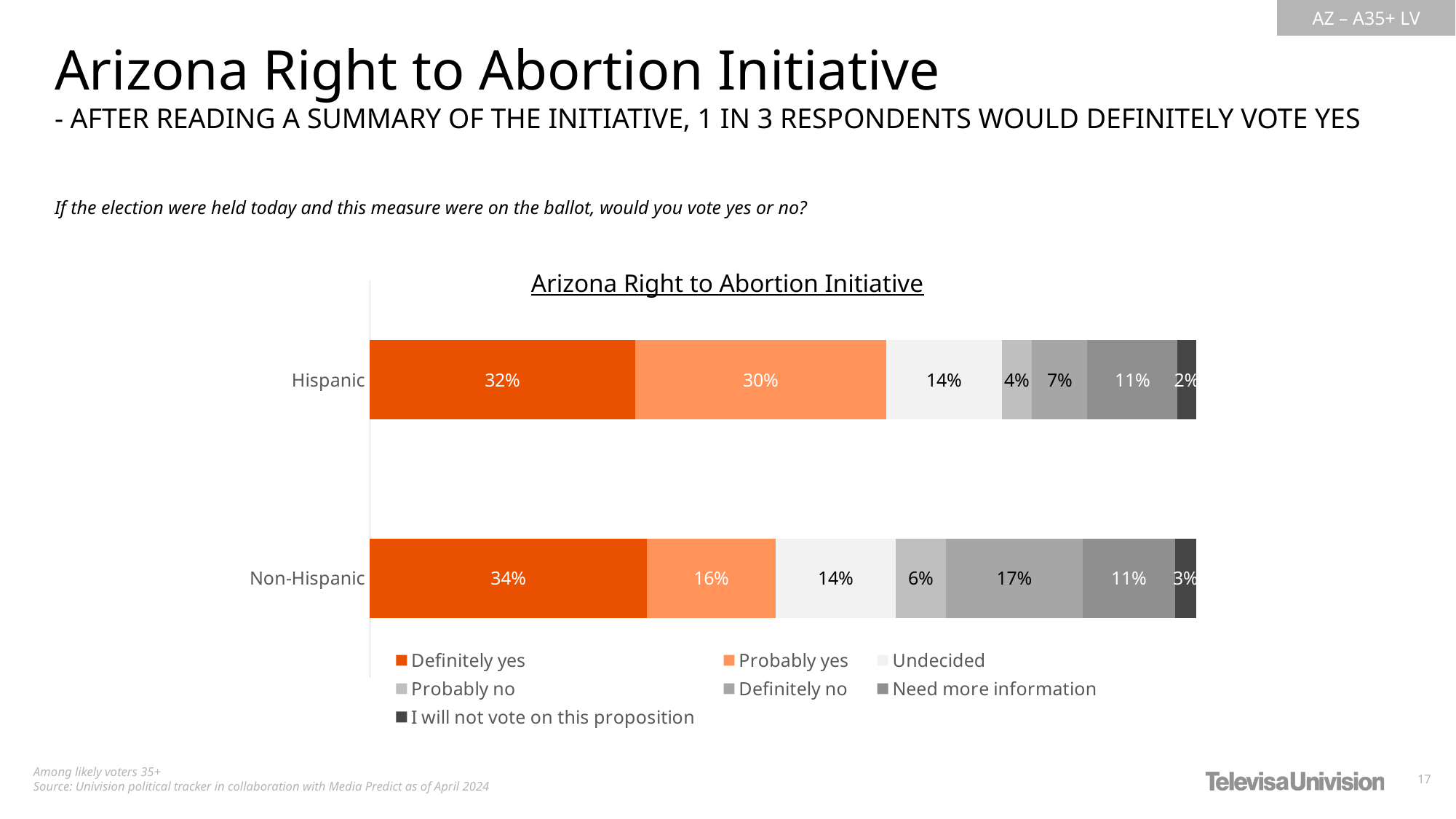
How many series does the legend list? 7 What percentage of Hispanic respondents would definitely vote yes? 32% What is the title of the chart? Arizona Right to Abortion Initiative Which response category has the highest value in the Hispanic bar? Definitely yes What share of Hispanic respondents said they need more information? 11% Which response category has the lowest value in the Non-Hispanic bar? I will not vote on this proposition Which group has the larger Definitely yes value, Hispanic or Non-Hispanic? Non-Hispanic What is the difference between the Probably yes values for Hispanic and Non-Hispanic respondents? 14 percentage points What is the Definitely no value for Non-Hispanic respondents? 17% What kind of chart is shown on the slide? Stacked bar chart What percentage of Non-Hispanic respondents would probably vote yes? 16% How many groups (bars) are shown in the chart? 2